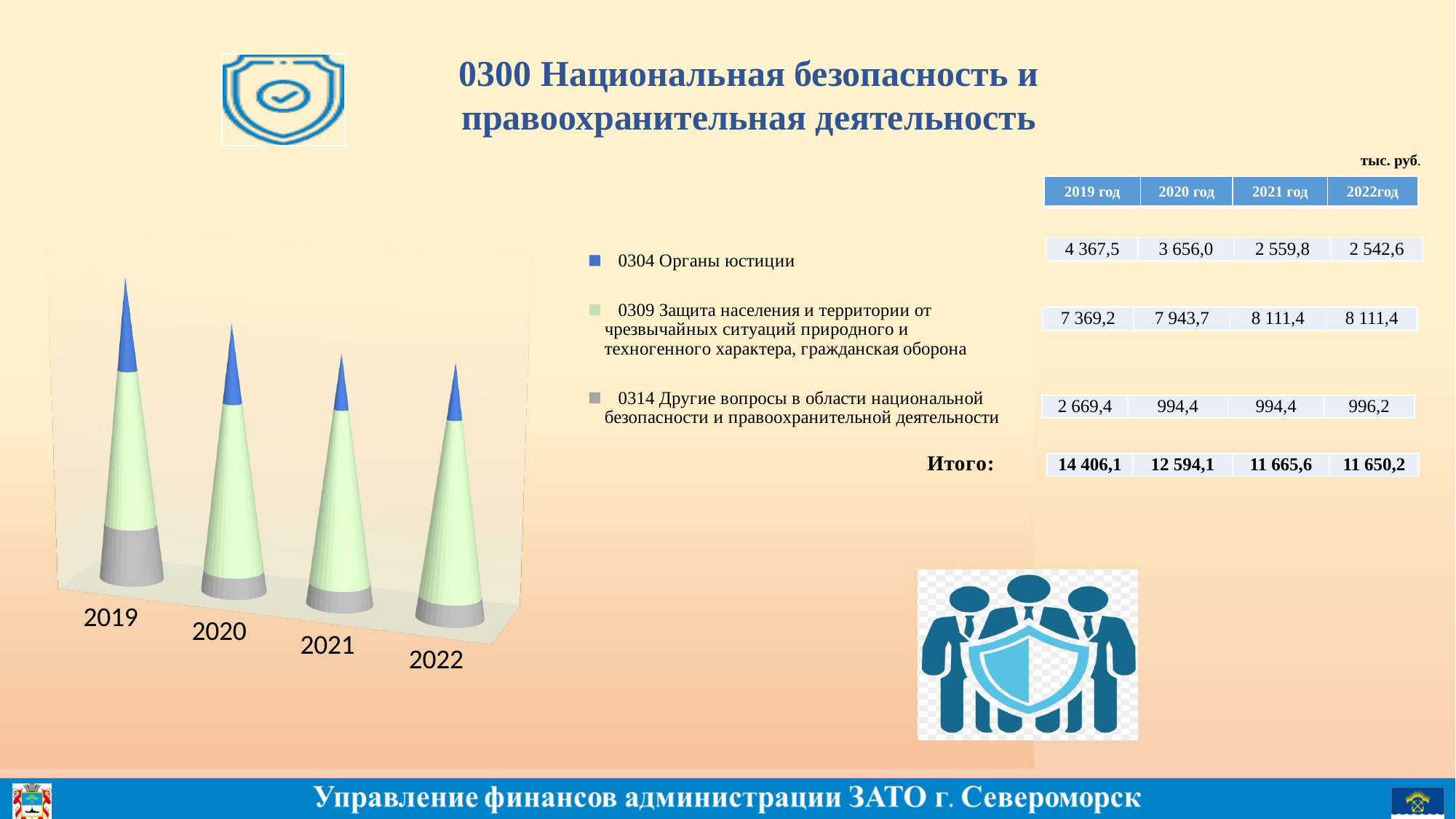
What kind of chart is shown on the slide? bar chart What is the value for 0314 Другие вопросы в области национальной безопасности in 2020? 994,4 What is the total (Итого) for 2019? 14 406,1 What is the difference between the 0304 Органы юстиции values for 2019 and 2020? 711,5 How many years (categories) are shown along the x axis of the chart? 4 What is the value for 0309 Защита населения и территории от чрезвычайных ситуаций in 2021? 8 111,4 How many series does the legend list? 3 Do the totals rise or fall from 2019 to 2022? fall Which year has the highest total? 2019 What is the value for 0304 Органы юстиции in 2019? 4 367,5 Which year has the lowest total? 2022 Which is larger: the 0309 value in 2019 or the 0309 value in 2020? 2020